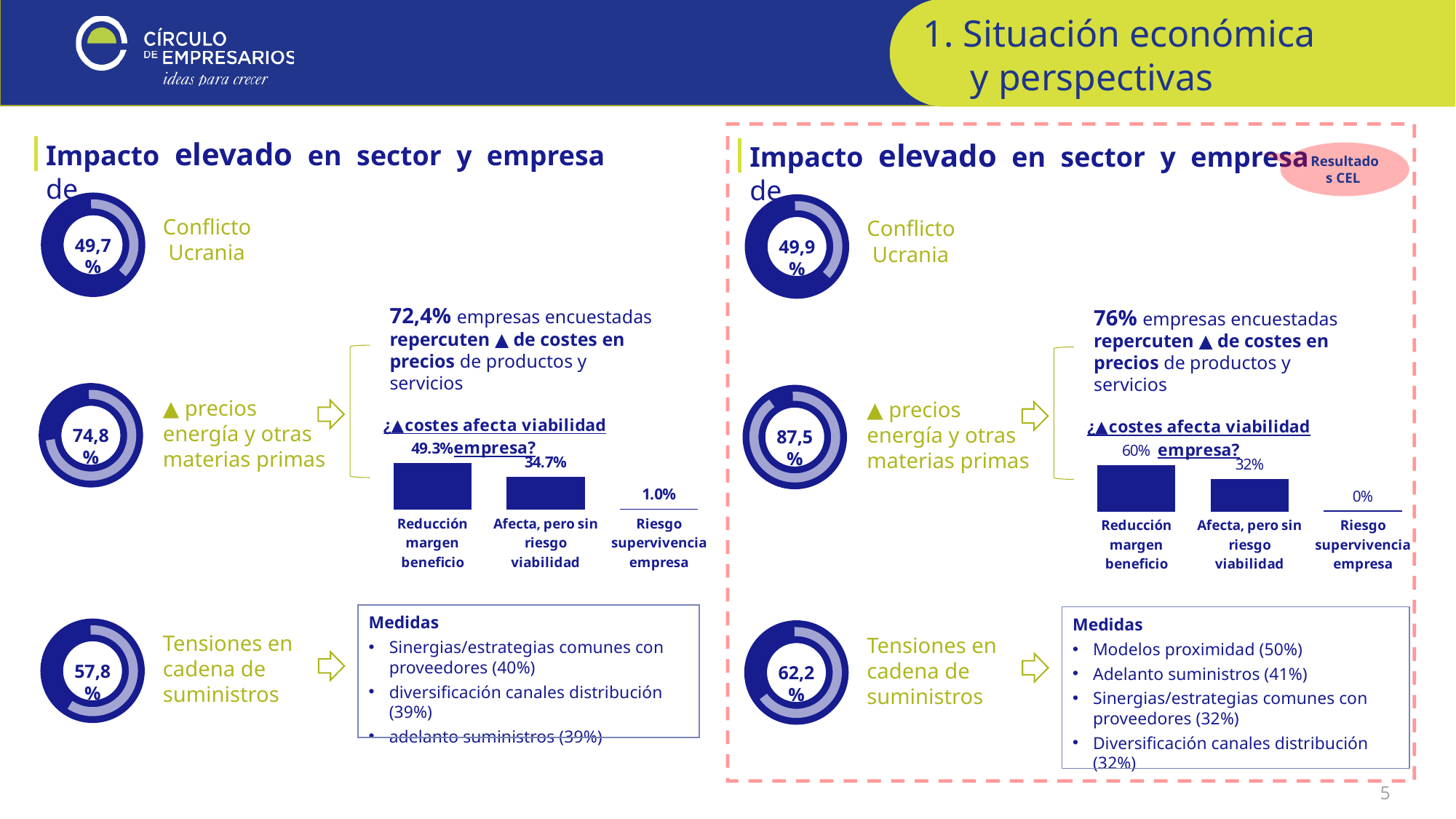
In the right bar chart '¿▲costes afecta viabilidad empresa?' (inside the dashed box), what is the difference between 'Reducción margen beneficio' and 'Afecta, pero sin riesgo viabilidad'? 28% In the right bar chart '¿▲costes afecta viabilidad empresa?' (inside the dashed box), which is larger: 'Reducción margen beneficio' or 'Afecta, pero sin riesgo viabilidad'? Reducción margen beneficio Do the values in the right bar chart '¿▲costes afecta viabilidad empresa?' (inside the dashed box) rise or fall from left to right? Fall How many categories does the left bar chart '¿▲costes afecta viabilidad empresa?' show? 3 In the left bar chart '¿▲costes afecta viabilidad empresa?', which category has the lowest value? Riesgo supervivencia empresa What value is shown in the donut chart for '▲ precios energía y otras materias primas' on the right side of the slide (inside the dashed box)? 87,5% In the left bar chart '¿▲costes afecta viabilidad empresa?', what is the value for 'Reducción margen beneficio'? 49.3% In the right bar chart '¿▲costes afecta viabilidad empresa?' (inside the dashed box), which category has the highest value? Reducción margen beneficio What kind of chart is used for '¿▲costes afecta viabilidad empresa?' on the left side of the slide? Bar chart In the left bar chart '¿▲costes afecta viabilidad empresa?', what is the value for 'Afecta, pero sin riesgo viabilidad'? 34.7% In the left bar chart '¿▲costes afecta viabilidad empresa?', what is the difference between 'Reducción margen beneficio' and 'Afecta, pero sin riesgo viabilidad'? 14.6% In the right bar chart '¿▲costes afecta viabilidad empresa?' (inside the dashed box), what is the value for 'Riesgo supervivencia empresa'? 0%